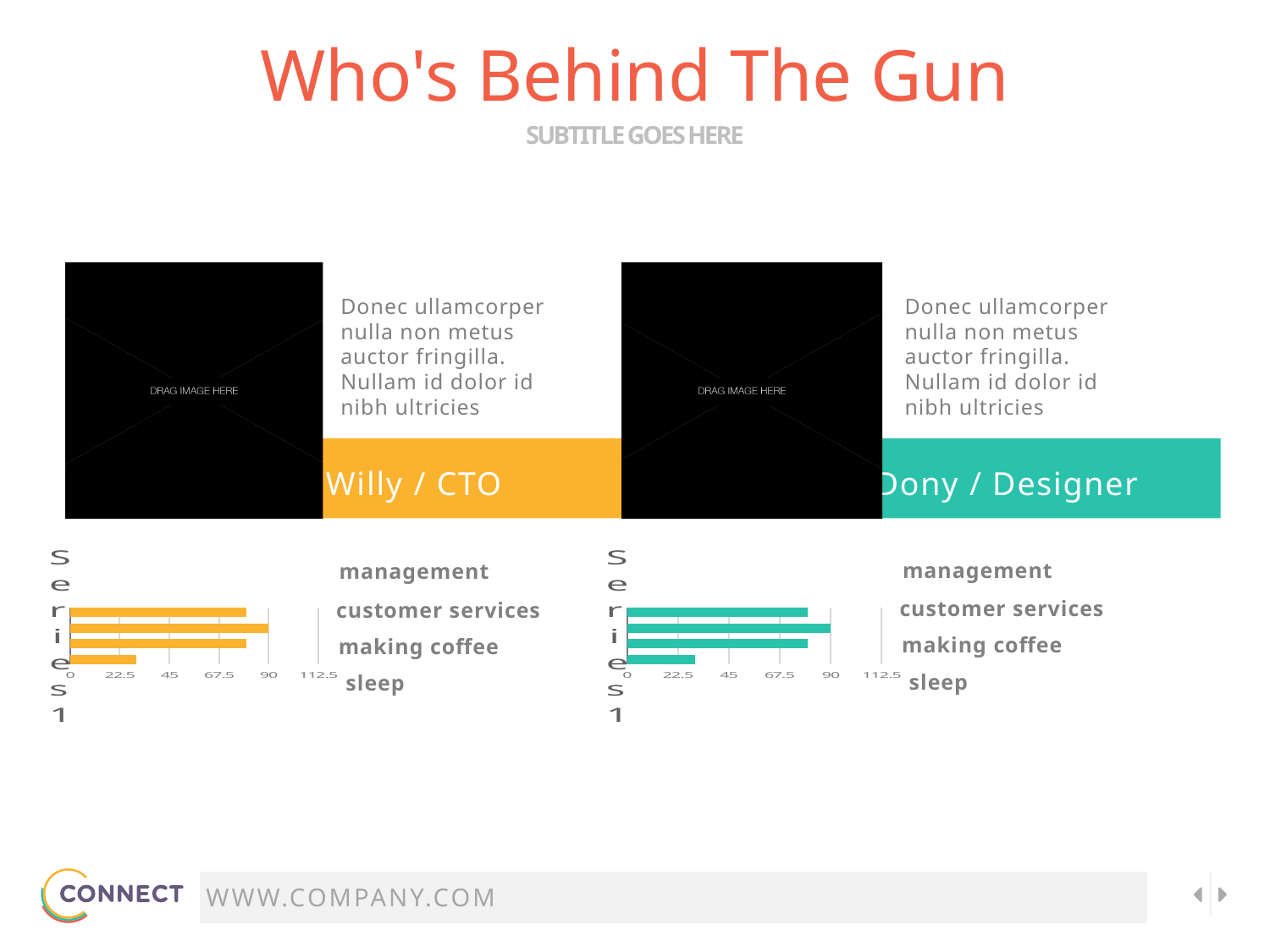
In the chart under Willy / CTO, is the value of the bottom bar greater or less than 45? less What kind of chart is shown under Willy / CTO? bar chart How many bars does the chart under Dony / Designer have? 4 What is the highest tick value shown on the x axis of the chart under Willy / CTO? 112.5 In the chart under Dony / Designer, is the value of the bottom bar greater or less than 45? less In the chart under Dony / Designer, is the value of the top bar greater or less than 67.5? greater In the chart under Willy / CTO, which is larger, the top bar or the bottom bar? the top bar In the chart under Willy / CTO, which bar is the shortest? the bottom bar What colour are the bars in the chart under Dony / Designer? teal In the chart under Dony / Designer, which bar is the longest? the second bar from the top